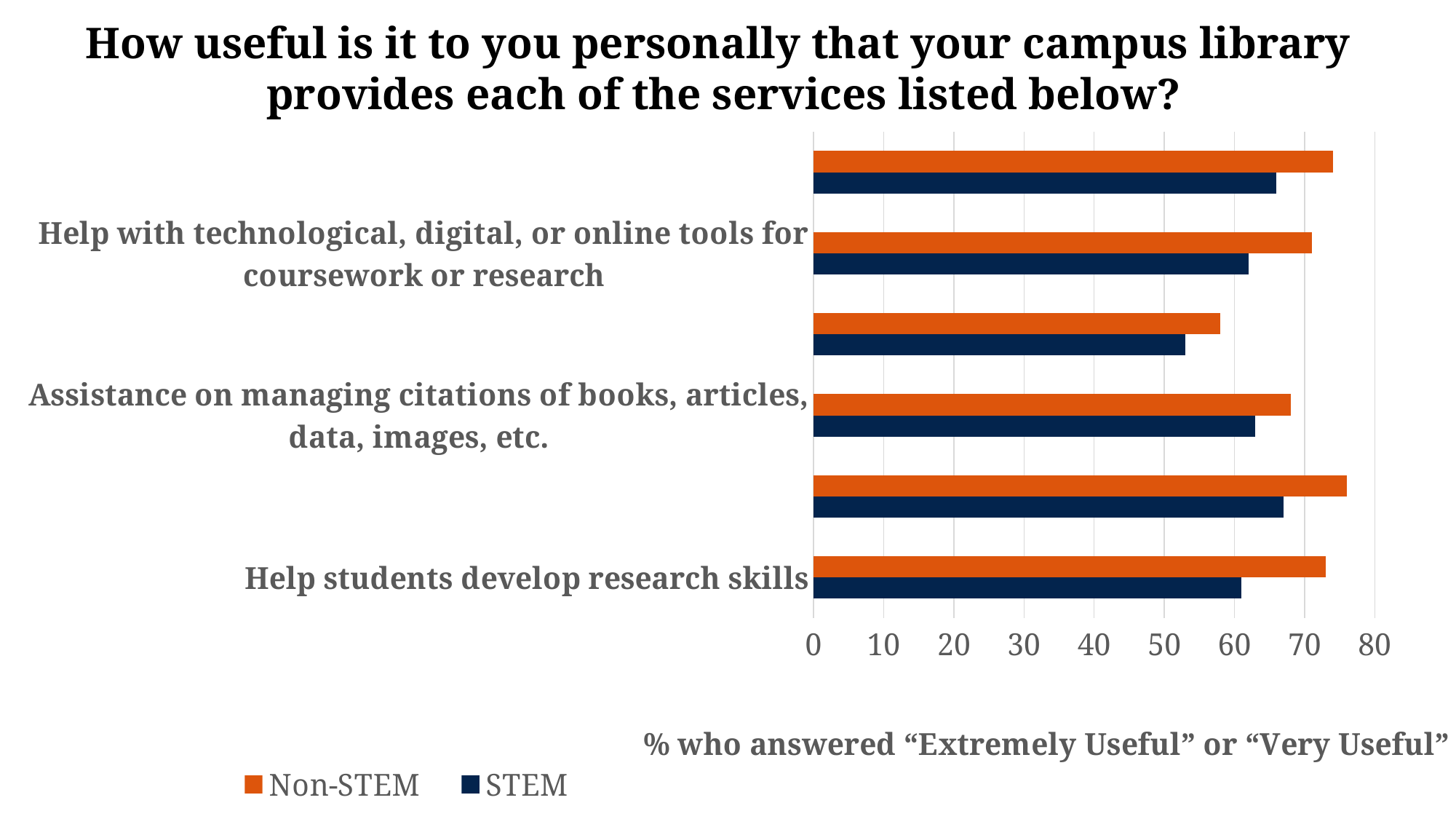
Is the Non-STEM value for "Help students develop research skills" greater or less than 70? greater What are the two series named in the legend? Non-STEM and STEM For "Help with technological, digital, or online tools for coursework or research", which group has the larger value, Non-STEM or STEM? Non-STEM For "Help students develop research skills", which group has the larger value, Non-STEM or STEM? Non-STEM Is the STEM value for "Help with technological, digital, or online tools for coursework or research" greater or less than 70? less Is the STEM value for "Help students develop research skills" greater or less than 70? less What does the x axis measure, according to the axis label? % who answered "Extremely Useful" or "Very Useful" For "Assistance on managing citations of books, articles, data, images, etc.", which group has the larger value, Non-STEM or STEM? Non-STEM How many series does the legend list? 2 What kind of chart is shown on the slide? bar chart